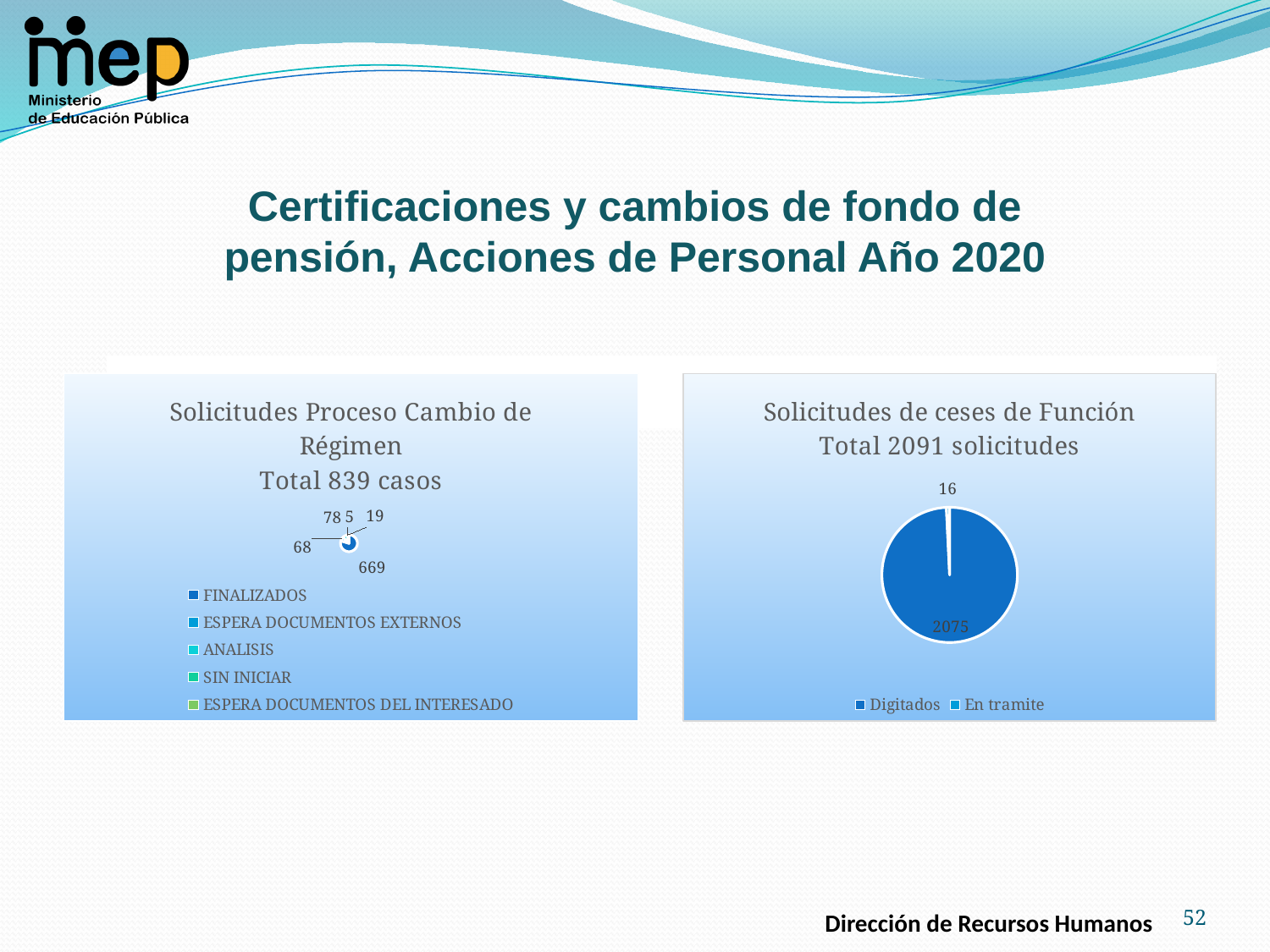
In the 'Solicitudes de ceses de Función' chart, which is larger, Digitados or En tramite? Digitados In the 'Solicitudes de ceses de Función' chart, what is the value for Digitados? 2075 In the 'Solicitudes Proceso Cambio de Régimen' chart, what is the largest value shown? 669 What kind of chart is the 'Solicitudes de ceses de Función' chart on the right? pie chart In the 'Solicitudes de ceses de Función' chart, what is the value for En tramite? 16 According to its title, what is the total number of casos in the 'Solicitudes Proceso Cambio de Régimen' chart? 839 How many categories does the legend of the 'Solicitudes Proceso Cambio de Régimen' chart on the left list? 5 According to its title, what is the total number of solicitudes in the 'Solicitudes de ceses de Función' chart? 2091 What kind of chart is the 'Solicitudes Proceso Cambio de Régimen' chart on the left? pie chart In the 'Solicitudes de ceses de Función' chart, what is the difference between Digitados and En tramite? 2059 How many entries does the legend of the 'Solicitudes de ceses de Función' chart list? 2 In the 'Solicitudes Proceso Cambio de Régimen' chart, which category has the largest share? FINALIZADOS